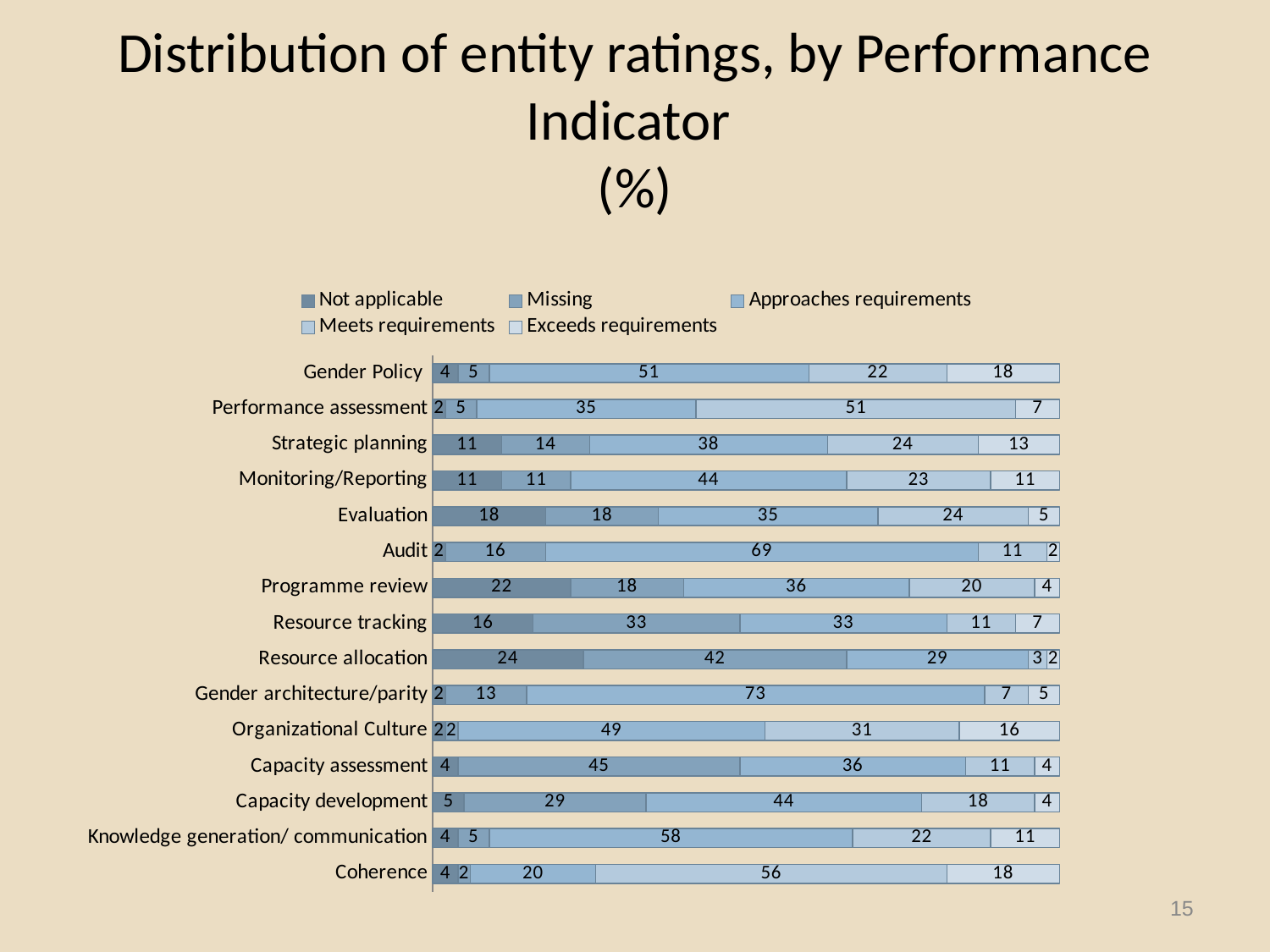
How many performance indicators are shown on the chart? 15 What is the Meets requirements value for Coherence? 56 What is the title of the chart? Distribution of entity ratings, by Performance Indicator (%) What is the total of the Strategic planning bar? 100 Which has a larger Not applicable value, Evaluation or Programme review? Programme review Which performance indicator has the highest Approaches requirements value? Gender architecture/parity What is the Exceeds requirements value for Organizational Culture? 16 What is the difference between the Meets requirements and Exceeds requirements values for Performance assessment? 44 Which performance indicator has the highest Not applicable value? Resource allocation How many series does the legend list? 5 What kind of chart is shown on the slide? Stacked bar chart What is the Approaches requirements value for Audit? 69